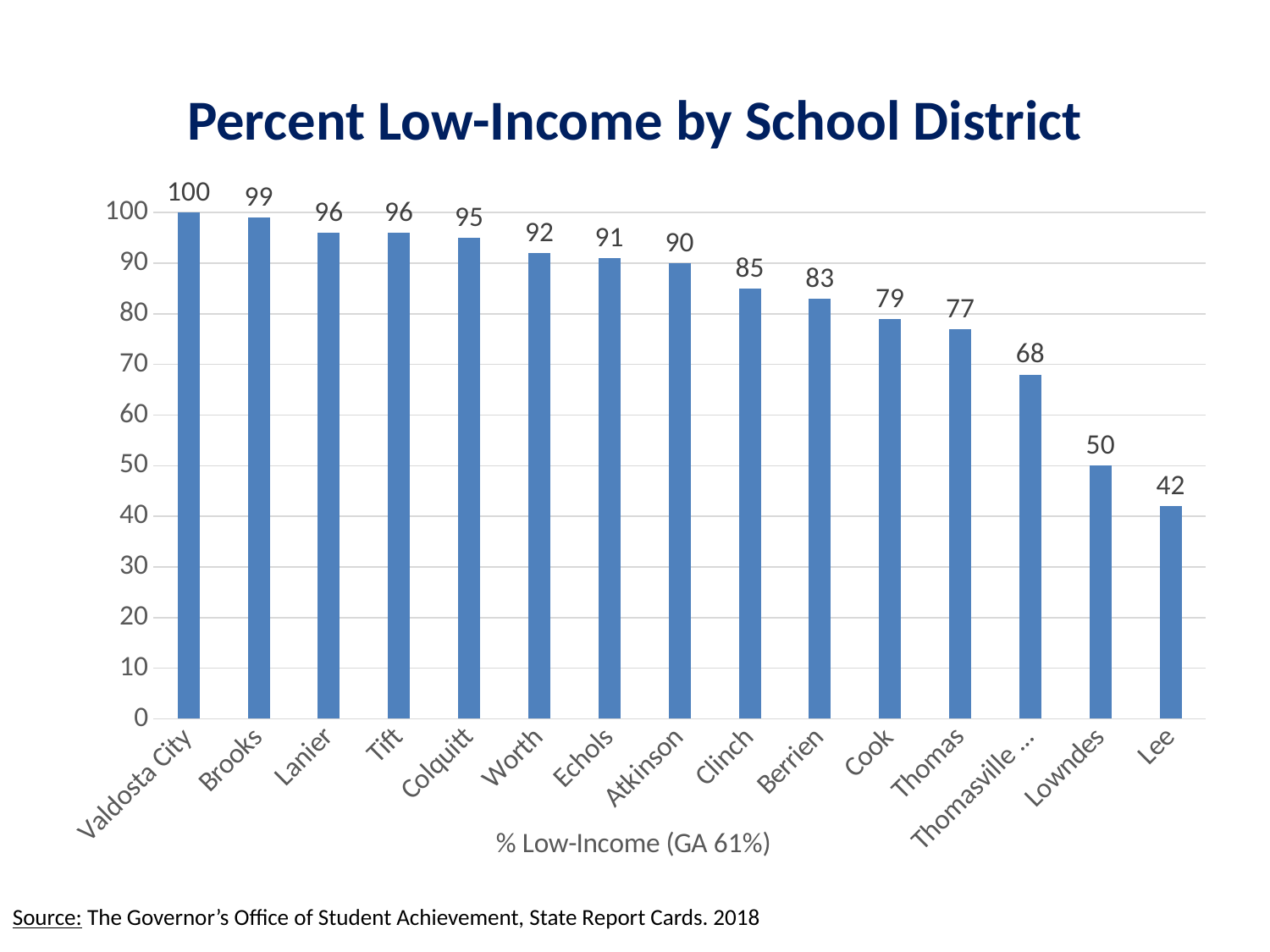
What is the percent low-income value for Cook? 79 Which school district has the highest percent low-income? Valdosta City What is the difference between the values for Brooks and Lee? 57 How many school districts are shown in the chart? 15 What is the percent low-income value for Clinch? 85 Which has a higher percent low-income, Worth or Atkinson? Worth Is the value for Thomas greater or less than 70? greater Do the values rise or fall moving from left to right along the x axis? Fall Which school district has the lowest percent low-income? Lee What is the percent low-income value for Lowndes? 50 What kind of chart is shown on the slide? Bar chart What is the difference between the values for Berrien and Thomas? 6